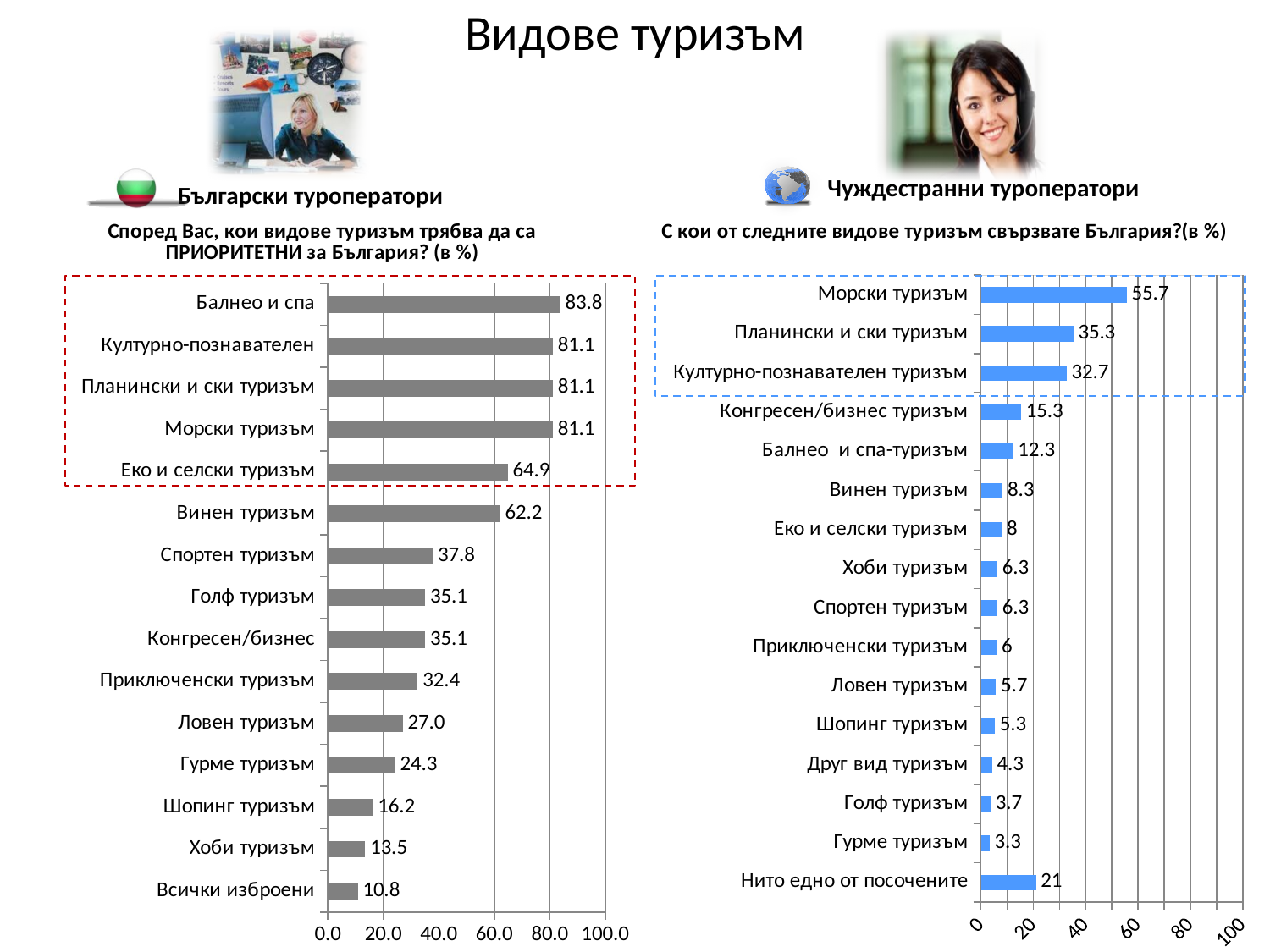
In the 'Чуждестранни туроператори' chart, what is the value for Нито едно от посочените? 21 In the 'Български туроператори' chart, what is the difference between Еко и селски туризъм and Винен туризъм? 2.7 In the 'Чуждестранни туроператори' chart, what is the difference between Морски туризъм and Планински и ски туризъм? 20.4 In the 'Български туроператори' chart, which category has the lowest value? Всички изброени In the 'Български туроператори' chart, what is the value for Балнео и спа? 83.8 In the 'Чуждестранни туроператори' chart, what is the value for Морски туризъм? 55.7 In the 'Чуждестранни туроператори' chart, how many categories are shown? 16 In the 'Чуждестранни туроператори' chart, which category has the lowest value? Гурме туризъм In the 'Български туроператори' chart, how many categories are shown? 15 What kind of chart is the 'Чуждестранни туроператори' chart? Bar chart In the 'Чуждестранни туроператори' chart, which is larger: Планински и ски туризъм or Културно-познавателен туризъм? Планински и ски туризъм In the 'Български туроператори' chart, which category has the highest value? Балнео и спа